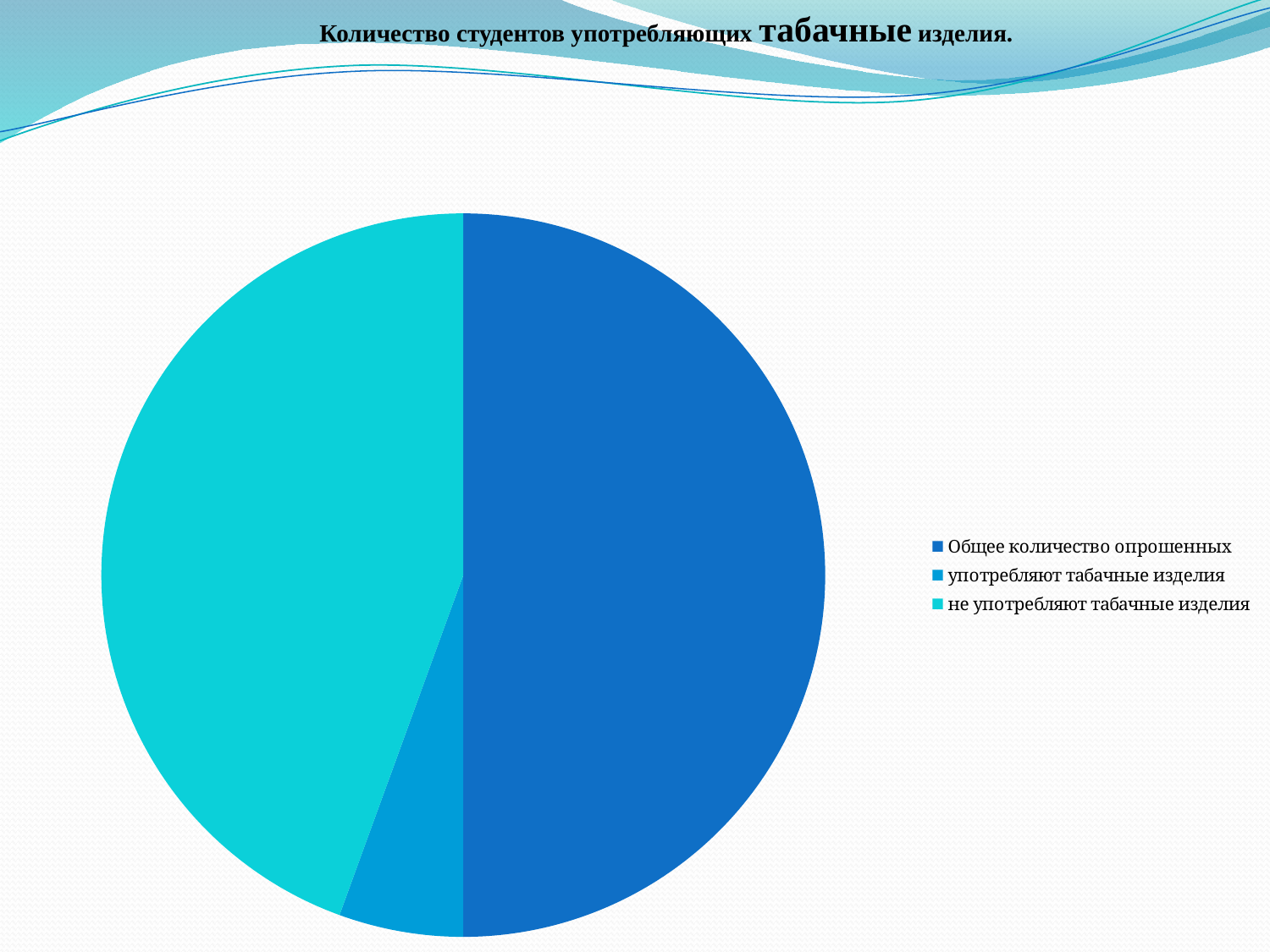
What kind of chart is shown on the slide? pie chart Which category has the largest slice of the pie chart? Общее количество опрошенных Which category has the smallest slice of the pie chart? употребляют табачные изделия Which slice is larger: "употребляют табачные изделия" or "не употребляют табачные изделия"? не употребляют табачные изделия What is the title of the slide with the pie chart? Количество студентов употребляющих табачные изделия. Which legend entry is shown in the dark blue colour on the pie chart? Общее количество опрошенных How many entries does the legend of the pie chart list? 3 Which slice is larger: "Общее количество опрошенных" or "употребляют табачные изделия"? Общее количество опрошенных How many slices does the pie chart have? 3